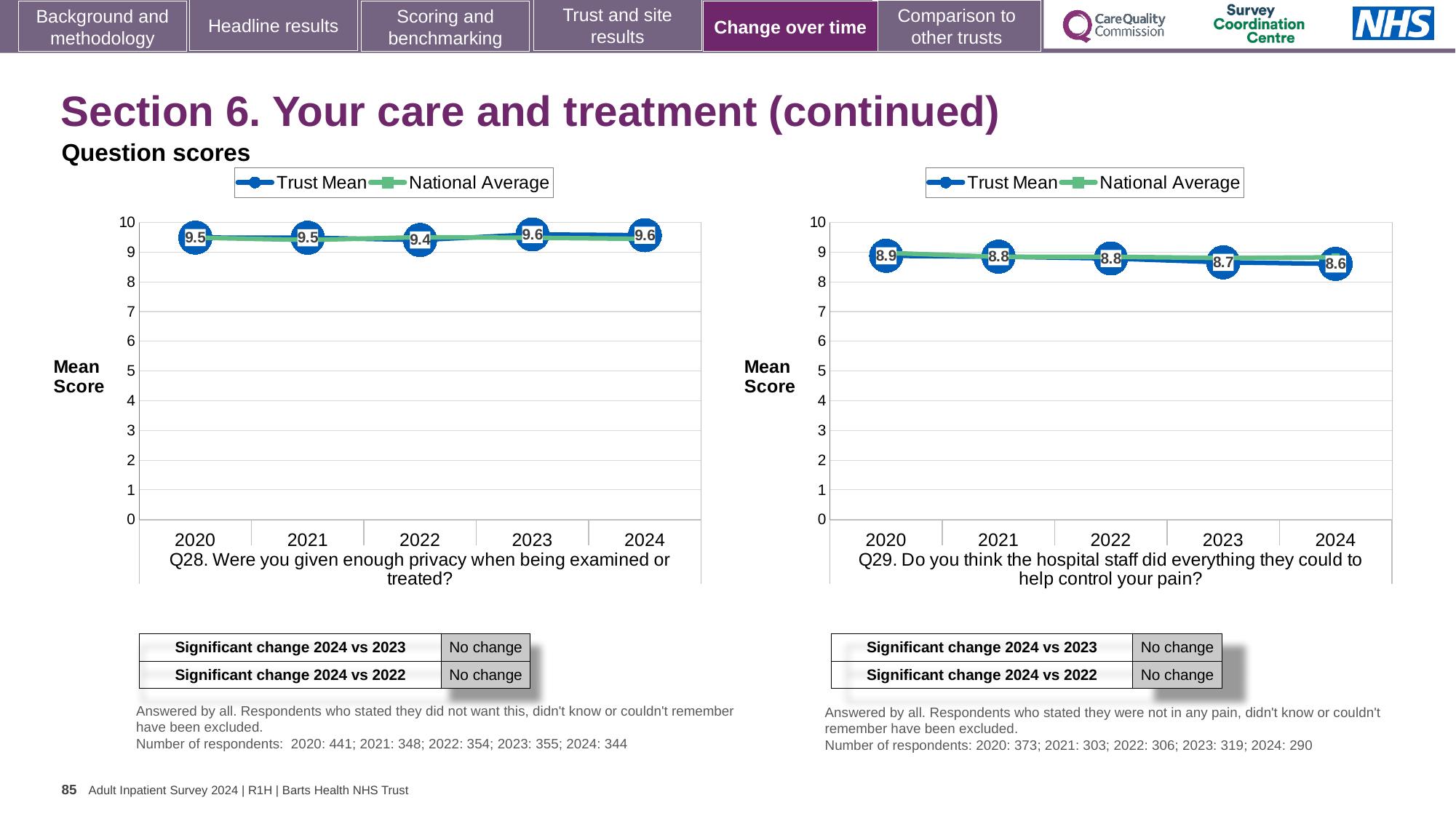
In the Q29 chart on the right, what is the Trust Mean score for 2020? 8.9 In the Q29 chart on the right, does the Trust Mean score generally rise or fall from 2020 to 2024? fall In the Q29 chart on the right, what is the difference between the Trust Mean scores for 2020 and 2024? 0.3 What type of chart is the Q28 chart on the left? line chart In the Q29 chart on the right, which year has the lowest Trust Mean score? 2024 In the Q28 chart on the left, what is the Trust Mean score for 2024? 9.6 How many series does the legend of the Q29 chart on the right list? 2 In the Q29 chart on the right, which year has the highest Trust Mean score? 2020 In the Q29 chart on the right, what is the Trust Mean score for 2024? 8.6 How many years are shown on the x axis of the Q28 chart on the left? 5 In the Q28 chart on the left, which year has the lowest Trust Mean score? 2022 In the Q28 chart on the left, what is the Trust Mean score for 2022? 9.4